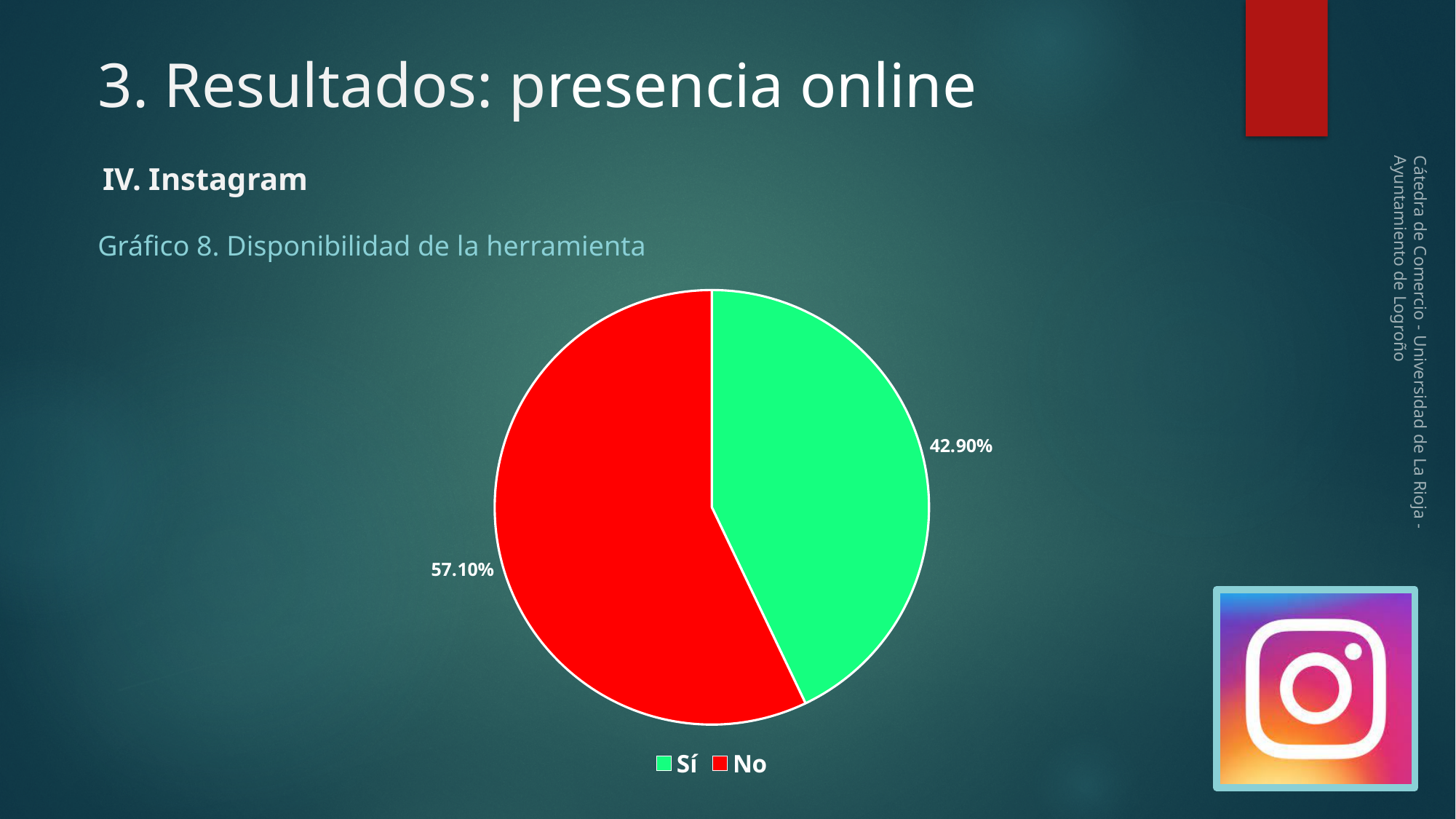
What is the difference in percentage points between the "No" share and the "Sí" share? 14.20% What is the title of the chart? Gráfico 8. Disponibilidad de la herramienta What percentage of the pie corresponds to "No"? 57.10% What type of chart is shown on the slide? pie chart Which category has the largest share of the pie? No What colour represents the "No" category in the pie chart? red Which category has the smallest share of the pie? Sí What percentage of the pie corresponds to "Sí"? 42.90% Which is larger, the share for "Sí" or the share for "No"? No How many slices does the pie chart have? 2 How many entries does the legend list? 2